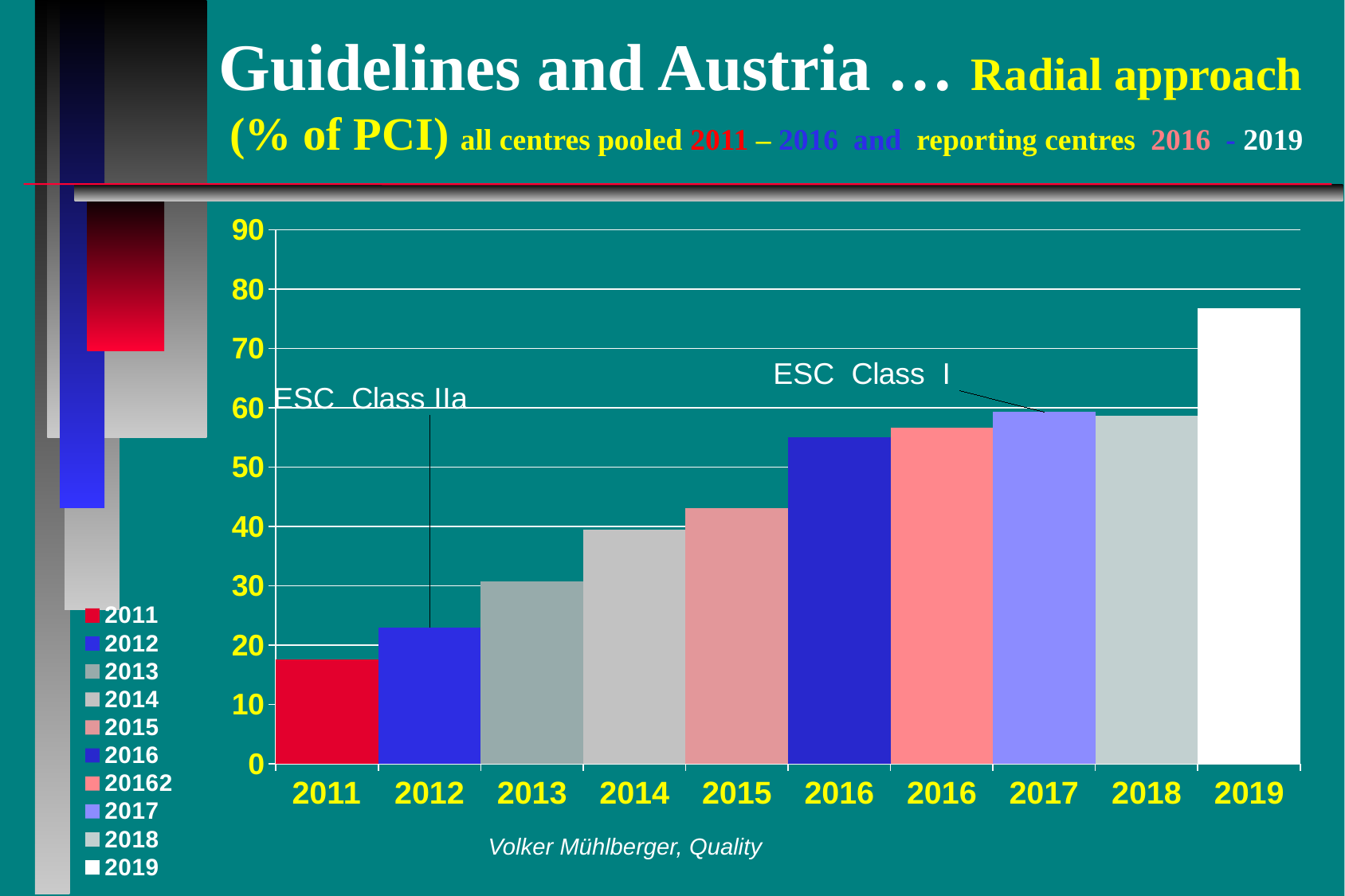
How many entries does the legend list? 10 Do the values generally rise or fall from 2011 to 2019 along the x axis? rise Which bar is taller, 2013 or 2015? 2015 Is the value for 2011 greater or less than 20? less Is the value for 2015 greater or less than 40? greater Is the value for 2019 greater or less than 70? greater Which year has the highest bar? 2019 Which ESC class annotation points to the 2017 bar? ESC Class I How many bars are plotted in the chart? 10 Which year has the lowest bar? 2011 What kind of chart is shown on the slide? bar chart